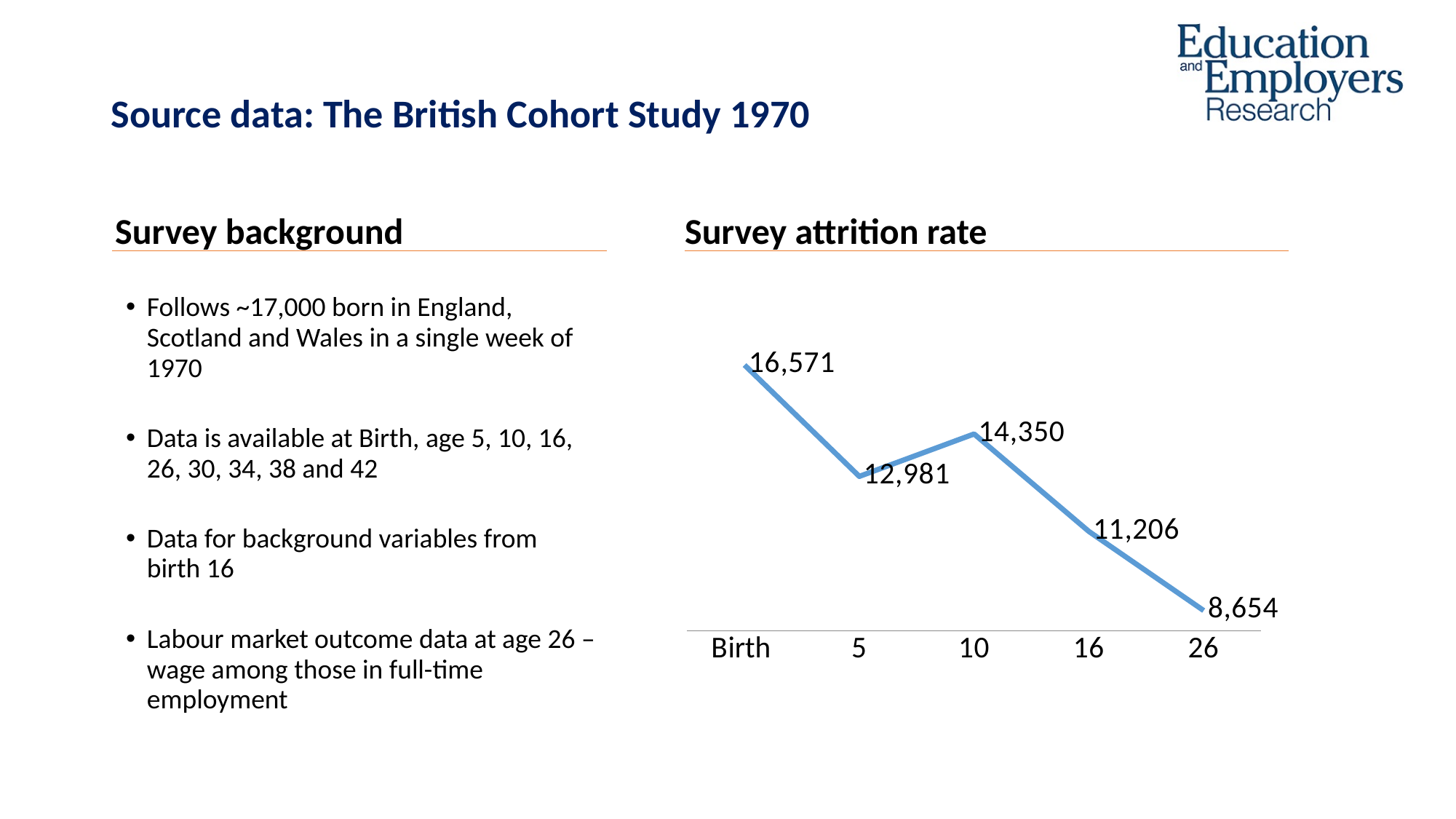
What is the title of the chart on the slide? Survey attrition rate Which point on the x axis has the highest value in the Survey attrition rate chart? Birth What is the value at age 26 in the Survey attrition rate chart? 8,654 What kind of chart is the Survey attrition rate chart? line chart What is the value at Birth in the Survey attrition rate chart? 16,571 How many data points are plotted in the Survey attrition rate chart? 5 What is the difference between the values at age 10 and age 5 in the Survey attrition rate chart? 1,369 Do the values in the Survey attrition rate chart generally rise or fall from Birth to age 26? fall Which is larger in the Survey attrition rate chart, the value at age 5 or at age 10? age 10 What is the difference between the values at Birth and at age 26 in the Survey attrition rate chart? 7,917 What is the value at age 10 in the Survey attrition rate chart? 14,350 Which point on the x axis has the lowest value in the Survey attrition rate chart? 26